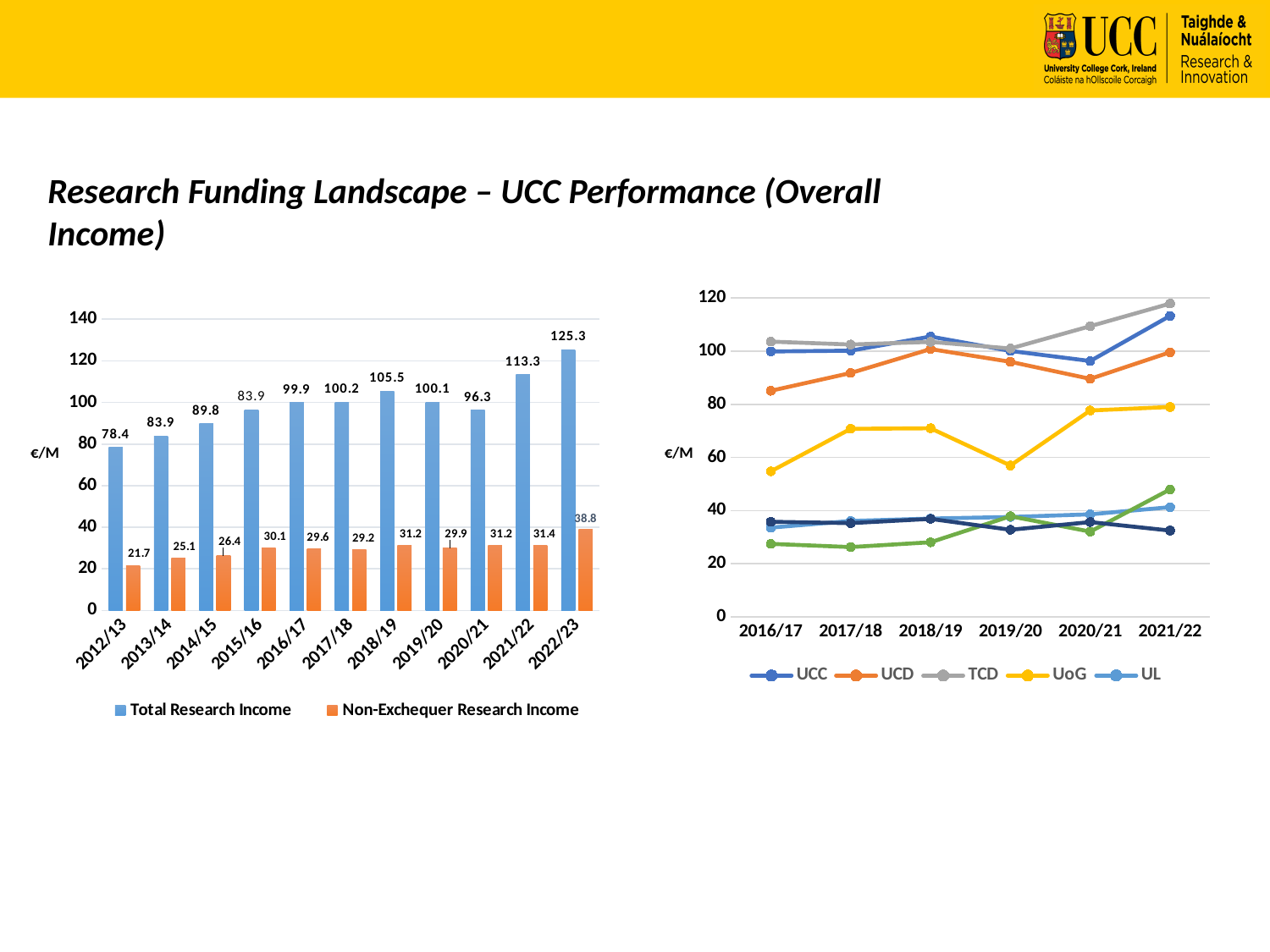
What kind of chart is the chart on the left of the slide? bar chart How many series does the legend of the left chart list? 2 In the left bar chart, which year has the lowest Non-Exchequer Research Income? 2012/13 In the left bar chart, what is the difference between Total Research Income in 2022/23 and 2021/22? 12.0 In the right line chart, is the value for TCD in 2021/22 greater or less than 100? greater How many years are shown on the x axis of the left bar chart? 11 In the left bar chart, what is the Total Research Income for 2022/23? 125.3 In the left bar chart, which year has the highest Total Research Income? 2022/23 What kind of chart is the chart on the right of the slide? line chart In the left bar chart, what is the Non-Exchequer Research Income for 2022/23? 38.8 In the left bar chart, what is the Non-Exchequer Research Income for 2012/13? 21.7 In the right line chart, which is larger in 2021/22, TCD or UCD? TCD